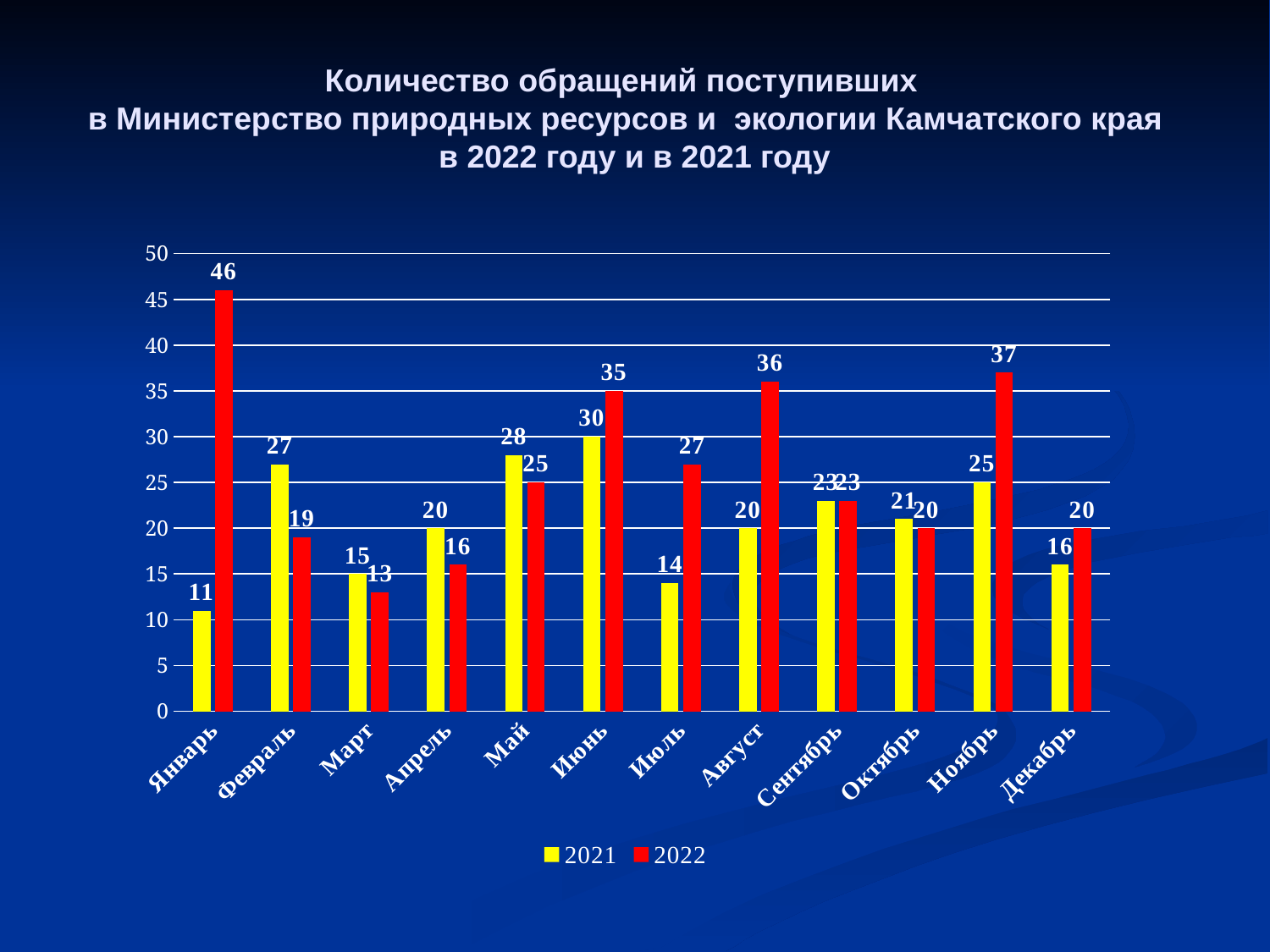
How many series does the legend list? 2 What is the value for 2022 in Январь? 46 What is the difference between the 2022 and 2021 values in Август? 16 Which month has the lowest value for the 2021 series? Январь Which colour represents the 2022 series? red What is the value for 2021 in Сентябрь? 23 What is the value for 2021 in Июль? 14 How many months are shown on the x axis? 12 What type of chart is shown on the slide? bar chart Which month has the highest value for the 2022 series? Январь Which is larger in Февраль, the 2021 value or the 2022 value? 2021 What is the difference between the 2021 and 2022 values in Ноябрь? 12